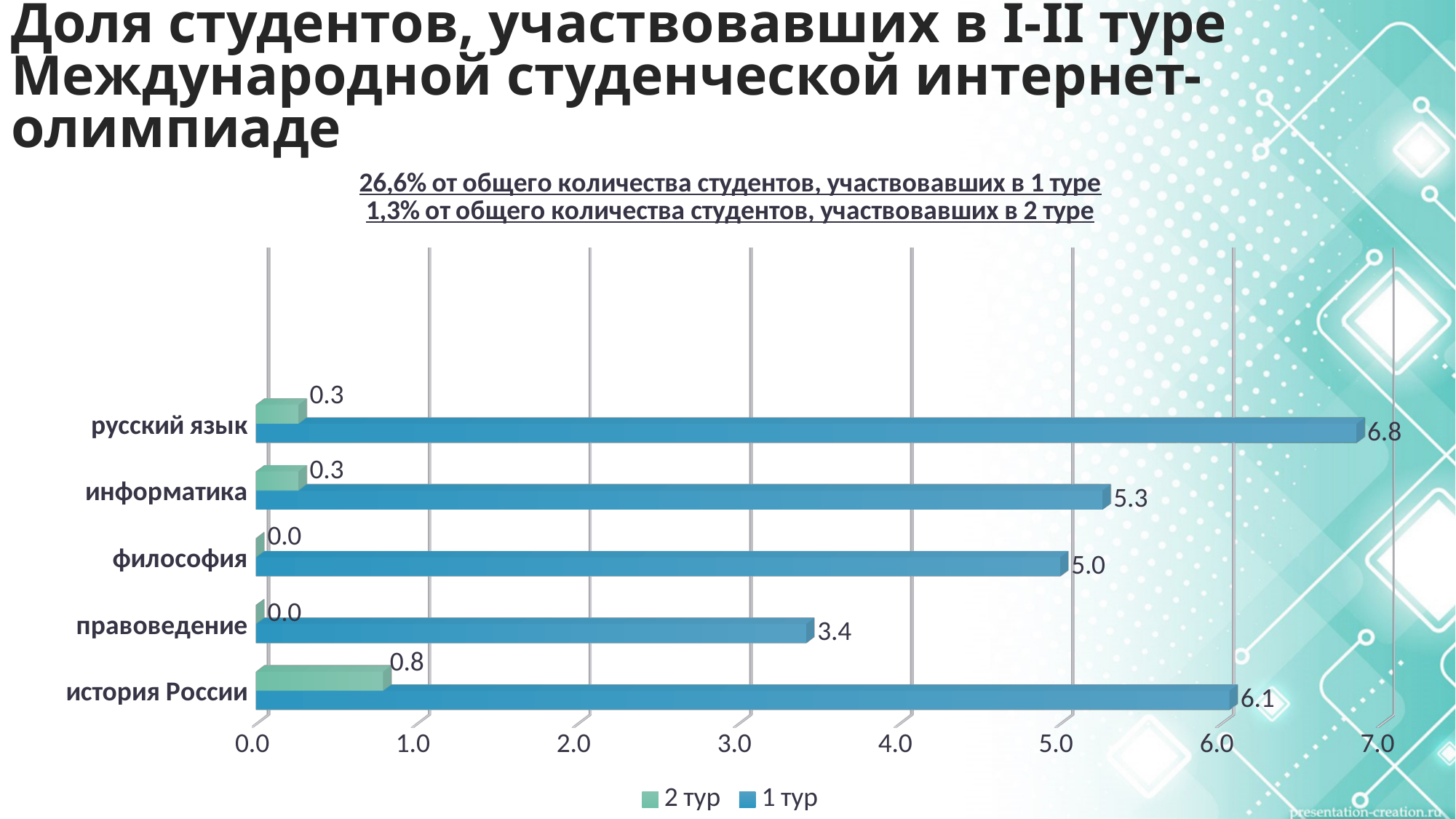
What is the difference between the 1 тур values for русский язык and информатика? 1.5 What is the value for философия in the 2 тур series? 0.0 Which category has the highest value in the 1 тур series? русский язык What is the value for русский язык in the 1 тур series? 6.8 Which category has the lowest value in the 1 тур series? правоведение Which is larger in the 1 тур series: философия or история России? история России How many series does the legend list? 2 What is the value for история России in the 2 тур series? 0.8 What kind of chart is shown on the slide? bar chart How many categories are shown on the chart? 5 What is the value for правоведение in the 1 тур series? 3.4 Which category has the highest value in the 2 тур series? история России